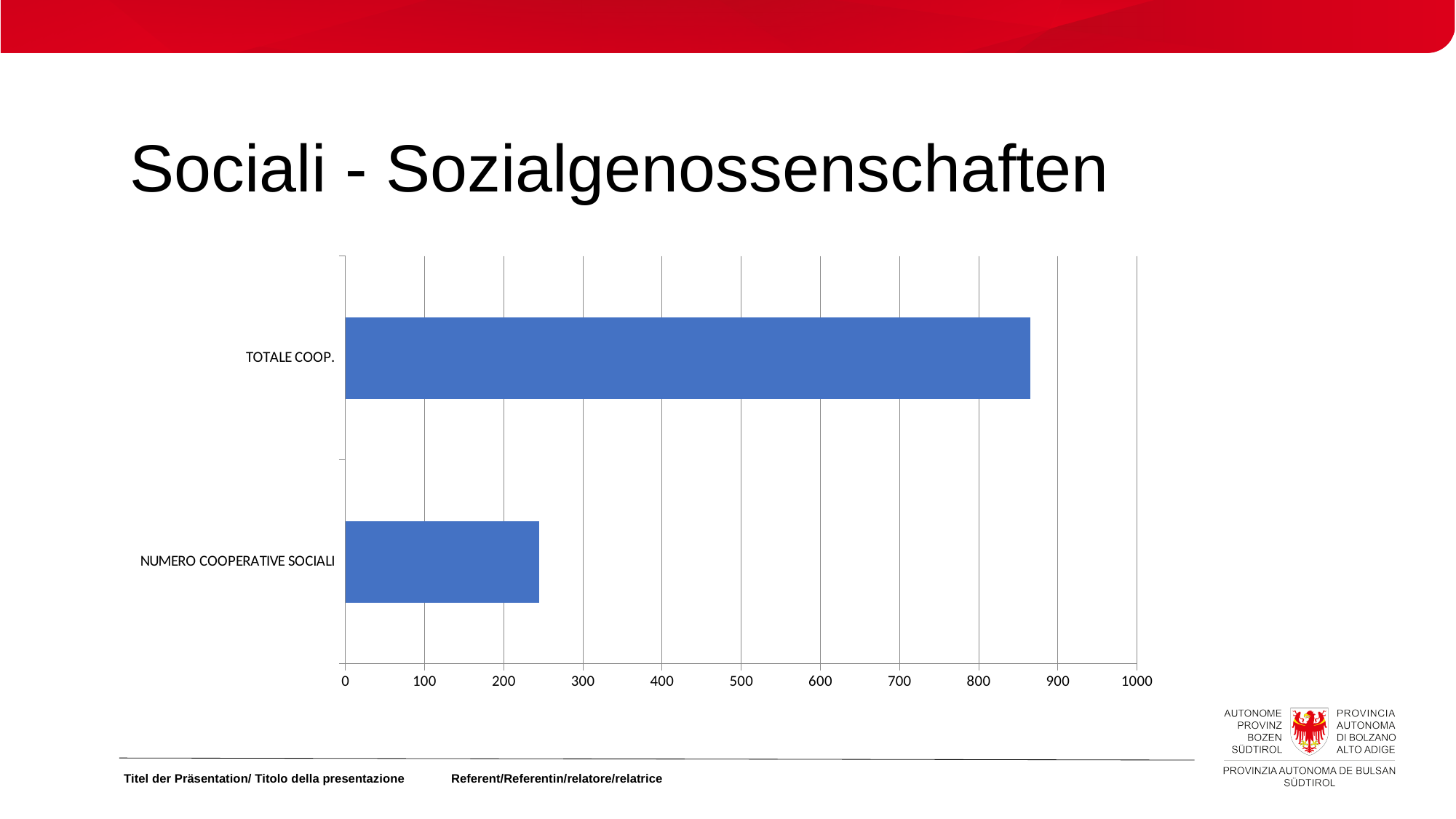
What is the title of the slide containing the chart? Sociali - Sozialgenossenschaften Is the value for TOTALE COOP. greater or less than 800? greater Is the value for TOTALE COOP. greater or less than 900? less Which category has the highest value in the bar chart? TOTALE COOP. Which is larger, the value for TOTALE COOP. or the value for NUMERO COOPERATIVE SOCIALI? TOTALE COOP. What kind of chart is shown on the slide? bar chart What is the highest value shown on the horizontal axis of the chart? 1000 Is the value for NUMERO COOPERATIVE SOCIALI greater or less than 300? less How many categories does the bar chart show? 2 Which category has the lowest value in the bar chart? NUMERO COOPERATIVE SOCIALI